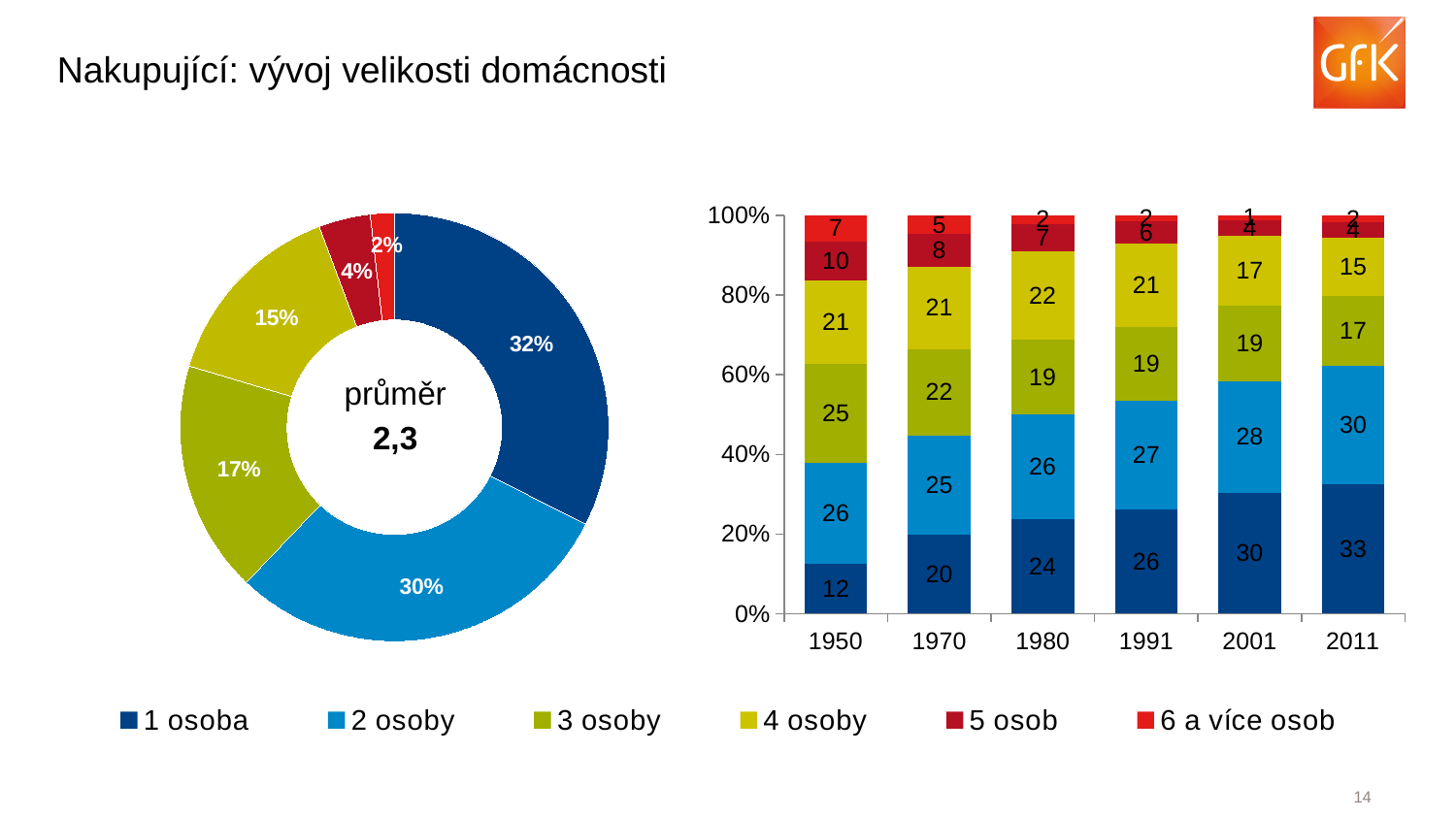
In the stacked bar chart on the right, what is the value for 2 osoby in 2011? 30 In the doughnut chart on the left, which category has the smallest slice? 6 a více osob In the stacked bar chart on the right, what is the value for 1 osoba in 1950? 12 In the stacked bar chart on the right, which year has the highest value for 1 osoba? 2011 In the stacked bar chart on the right, what is the difference between the 1 osoba values for 2011 and 1950? 21 In the stacked bar chart on the right, is the value for 3 osoby larger in 1950 or in 2011? 1950 In the doughnut chart on the left, what share does the 1 osoba slice have? 32% In the stacked bar chart on the right, what is the value for 4 osoby in 1980? 22 In the stacked bar chart on the right, which year has the lowest value for 5 osob? 2001 and 2011 (both 4) In the stacked bar chart on the right, does the value for 1 osoba rise or fall from 1950 to 2011? rise How many years are shown on the x axis of the stacked bar chart on the right? 6 How many series does the legend list? 6